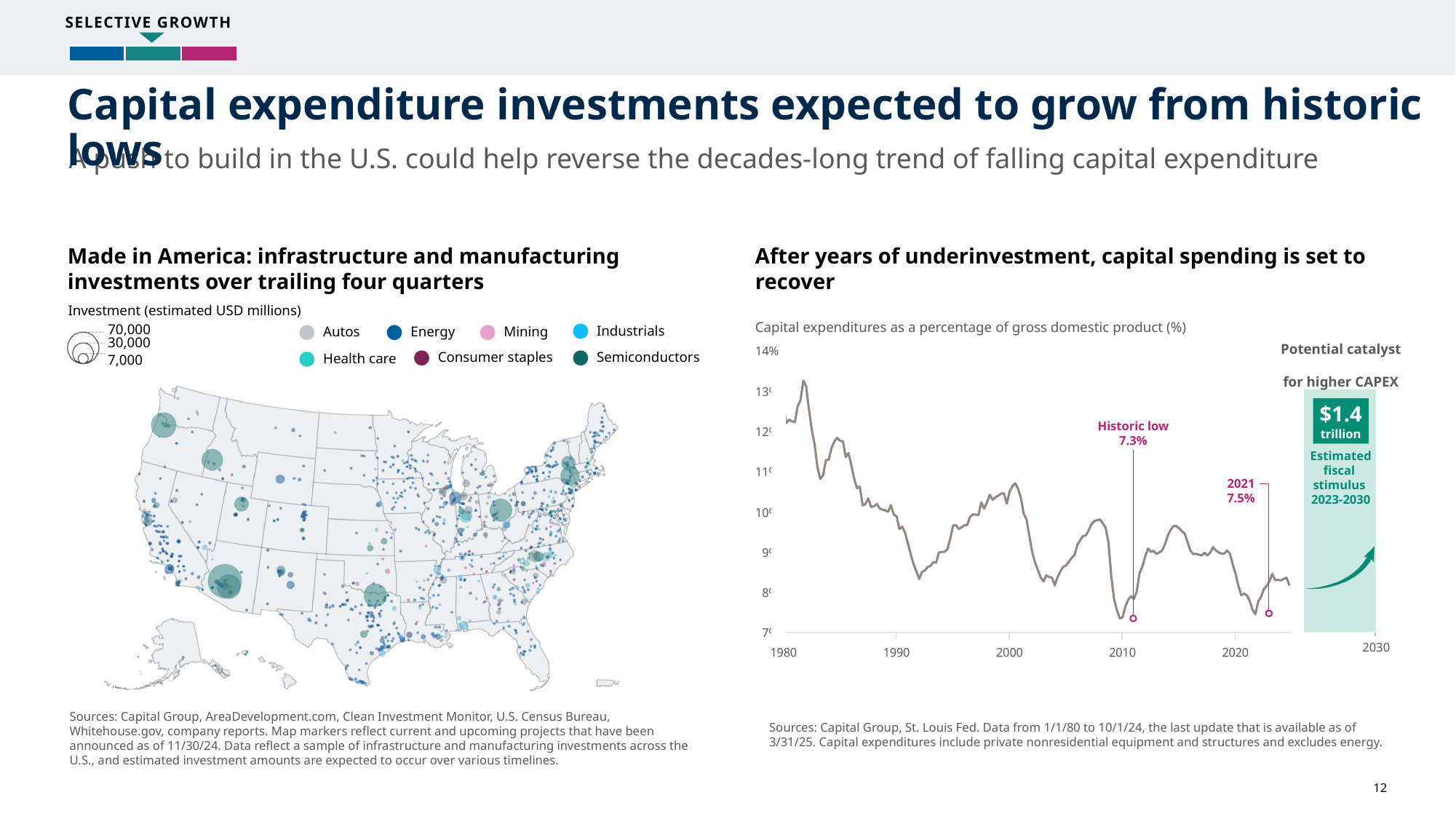
In the right-hand line chart, is the value at the early-1990s trough greater or less than 9%? less In the right-hand chart, what is the estimated fiscal stimulus for 2023-2030 shown as a potential catalyst for higher CAPEX? $1.4 trillion In the right-hand line chart, which is larger: the 2021 value or the historic low value? 2021 (7.5%) What kind of chart is the right-hand chart titled 'After years of underinvestment, capital spending is set to recover'? line chart How many sectors does the legend of the left-hand 'Made in America' map list? 7 In the right-hand line chart, what value is labelled as the historic low for capital expenditures as a percentage of GDP? 7.3% In the left-hand map's size legend, what is the largest investment amount shown (estimated USD millions)? 70,000 In the left-hand map's legend, which sector is represented by the dark green marker? Semiconductors In the right-hand line chart, does capital expenditure as a percentage of GDP generally rise or fall from 1980 to the end of the series? fall In the right-hand line chart, is the value at the early-1980s peak greater or less than 12%? greater In the right-hand line chart, what was capital expenditures as a percentage of GDP in 2021? 7.5% In the right-hand line chart, by how many percentage points does the 2021 value exceed the historic low? 0.2 percentage points